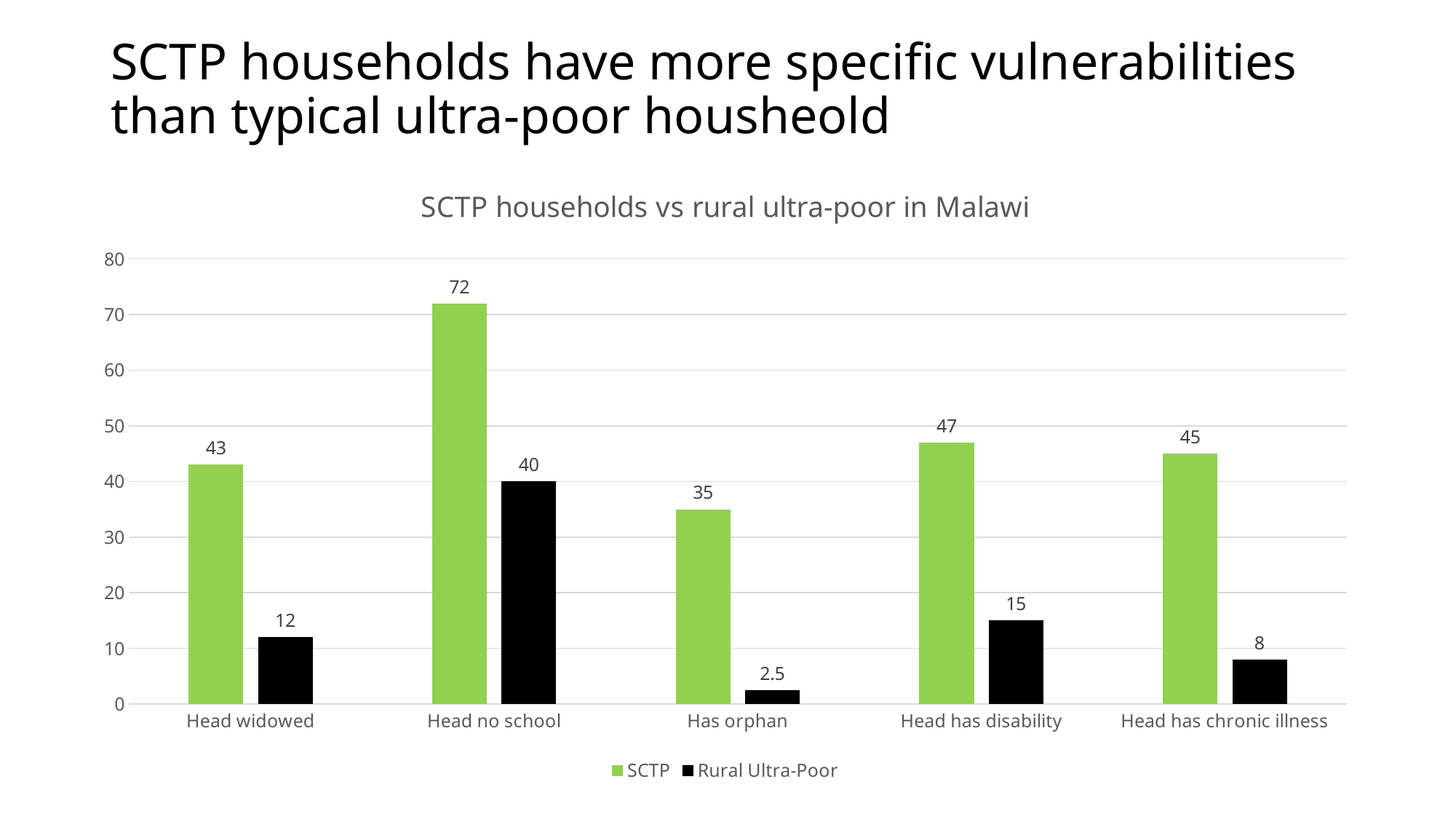
Which is larger, the Rural Ultra-Poor value for Head no school or the SCTP value for Has orphan? Rural Ultra-Poor value for Head no school What is the difference between the SCTP values for Head has disability and Head has chronic illness? 2 How many categories are shown on the x axis? 5 What kind of chart is shown on the slide? Bar chart Which category has the highest SCTP value? Head no school How many series does the legend list? 2 What is the difference between the SCTP and Rural Ultra-Poor values for Head widowed? 31 What is the title of the chart? SCTP households vs rural ultra-poor in Malawi Which category has the lowest Rural Ultra-Poor value? Has orphan What is the Rural Ultra-Poor value for Has orphan? 2.5 What is the Rural Ultra-Poor value for Head has disability? 15 What is the SCTP value for Head no school? 72